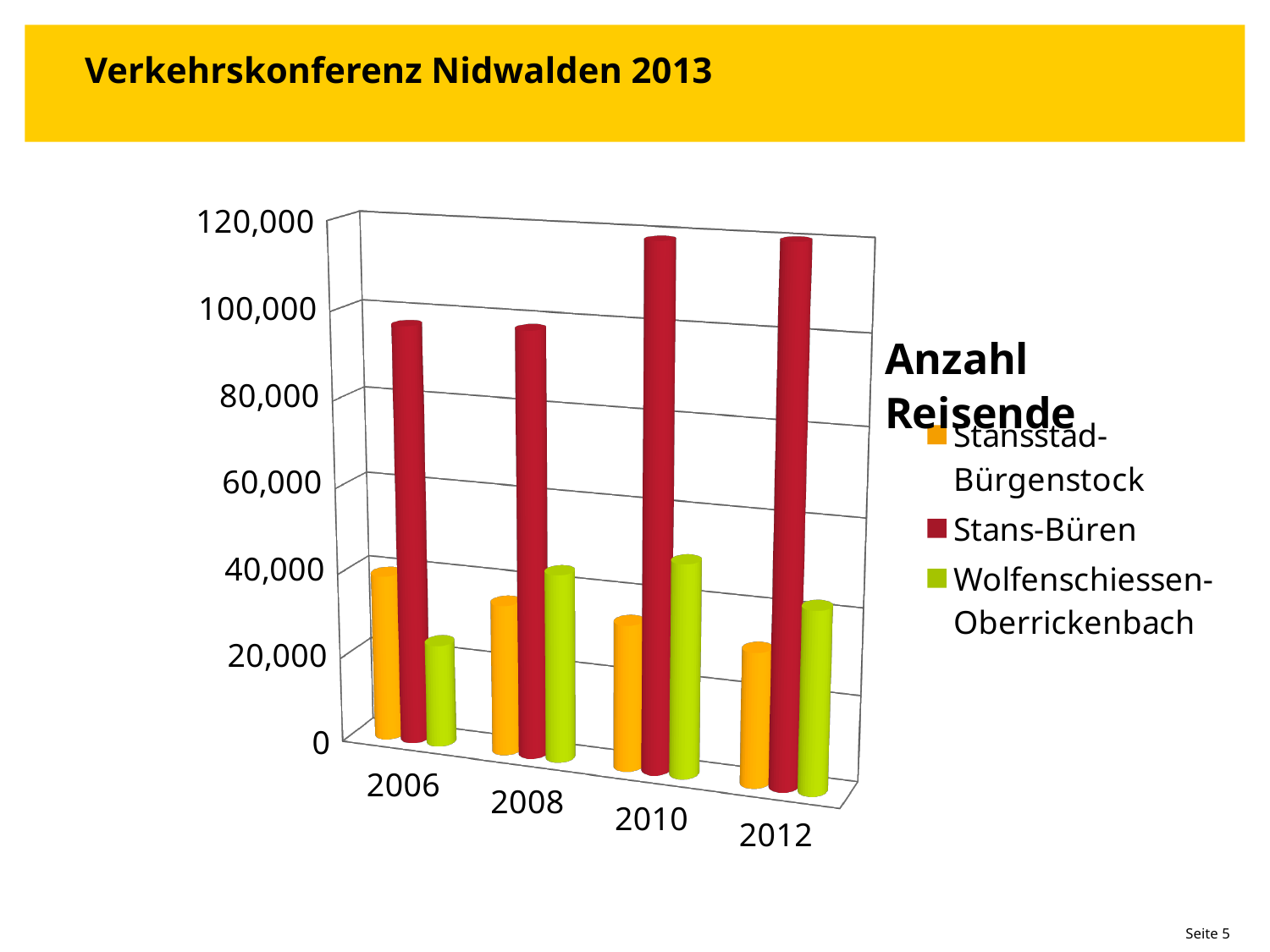
Which series has the highest value in 2010? Stans-Büren Is the value for Wolfenschiessen-Oberrickenbach in 2006 greater or less than 40,000? less Do the values for Stansstad-Bürgenstock rise or fall from 2006 to 2012? fall Which series has the lowest value in 2006? Wolfenschiessen-Oberrickenbach What is the title of the chart? Anzahl Reisende What kind of chart is shown on the slide? bar chart Is the value for Stansstad-Bürgenstock in 2012 greater or less than 40,000? less How many series does the legend list? 3 In 2012, which is larger: Stansstad-Bürgenstock or Wolfenschiessen-Oberrickenbach? Wolfenschiessen-Oberrickenbach Is the value for Stans-Büren in 2010 greater or less than 100,000? greater How many years are shown on the x axis? 4 In which year is the value for Stansstad-Bürgenstock highest? 2006